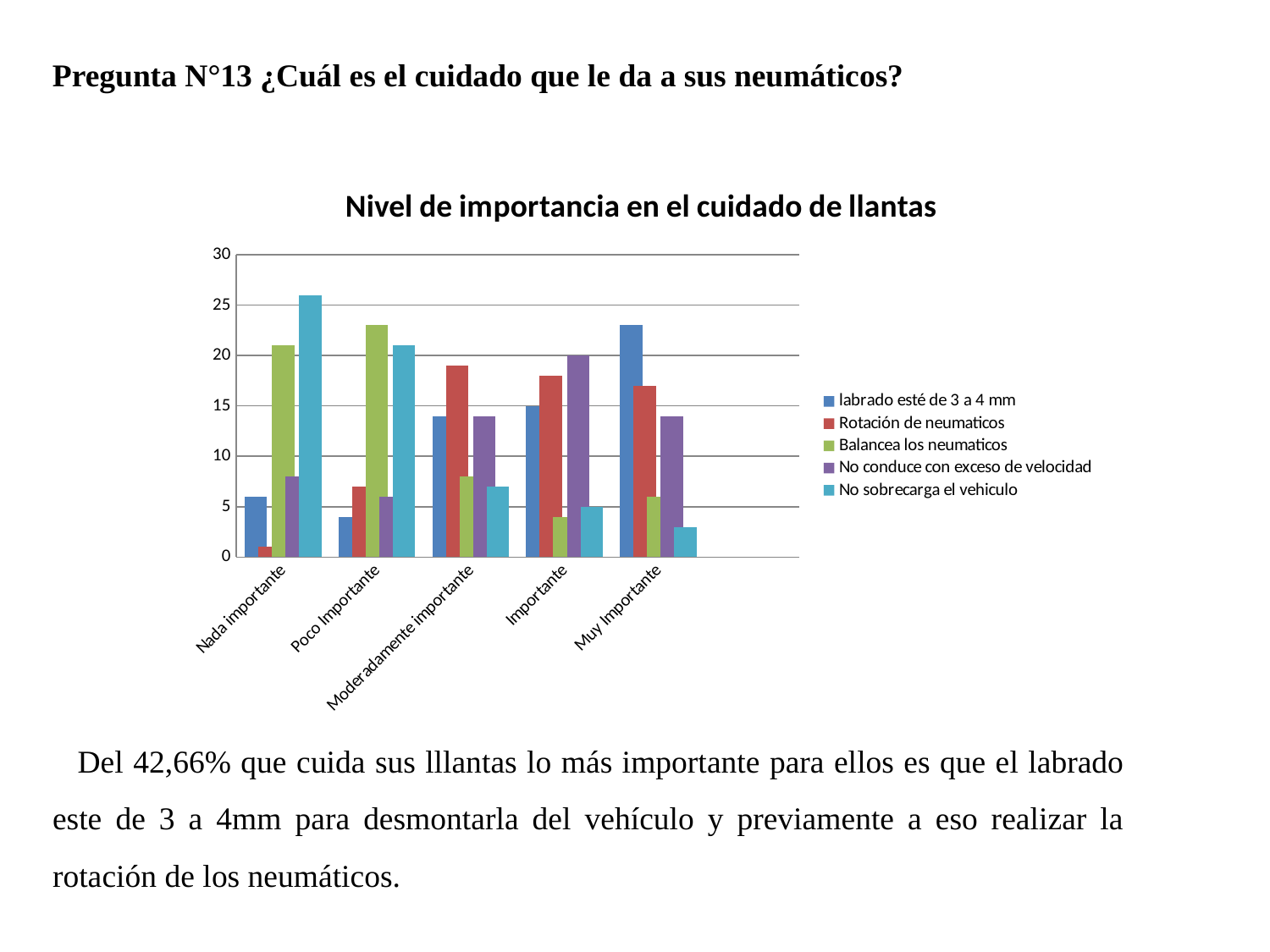
Which series has the lowest bar in the 'Muy Importante' category? No sobrecarga el vehiculo In the 'Moderadamente importante' category, which is larger: 'Rotación de neumaticos' or 'Balancea los neumaticos'? Rotación de neumaticos What is the title of the chart? Nivel de importancia en el cuidado de llantas Is the value for 'Rotación de neumaticos' at 'Nada importante' greater or less than 5? less How many categories are shown on the x axis? 5 What type of chart is shown on the slide? bar chart Is the value for 'No sobrecarga el vehiculo' at 'Nada importante' greater or less than 25? greater Does the value for 'No sobrecarga el vehiculo' rise or fall from 'Nada importante' to 'Muy Importante'? fall Is the value for 'labrado esté de 3 a 4 mm' at 'Muy Importante' greater or less than 20? greater Which series has the highest bar in the 'Nada importante' category? No sobrecarga el vehiculo How many series does the legend list? 5